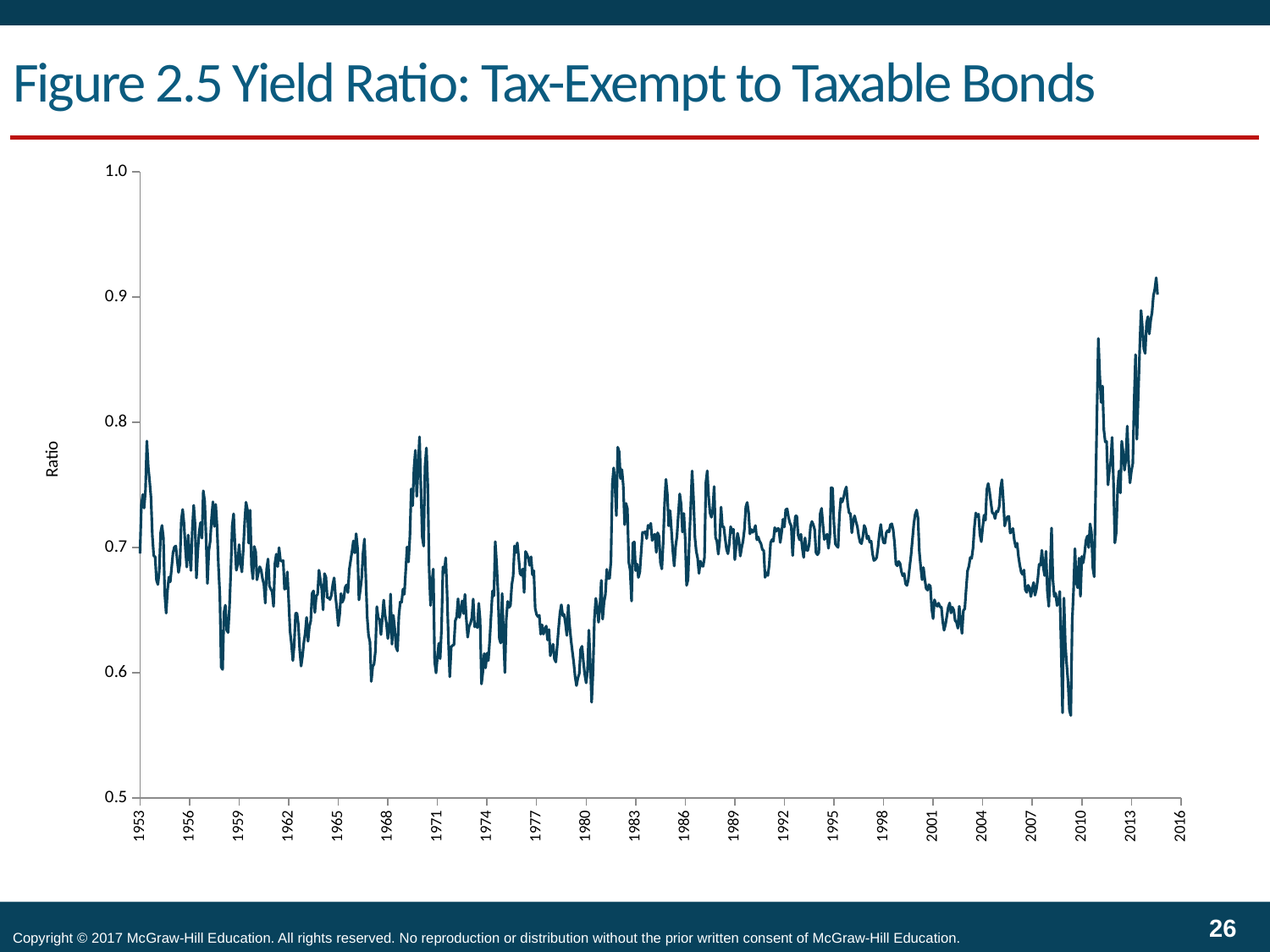
Is the lowest value reached by the ratio greater or less than 0.6? less What is the first year shown on the x axis? 1953 What is the label on the vertical axis? Ratio What is the lowest value marked on the y axis? 0.5 What is the highest value marked on the y axis? 1.0 What is the title of the chart? Figure 2.5 Yield Ratio: Tax-Exempt to Taxable Bonds What is the last year shown on the x axis? 2016 Is the peak value reached near the end of the series (around 2015) greater or less than 0.8? greater How many lines (data series) are plotted on the chart? 1 Does the ratio reach its highest value at the beginning or at the end of the period shown? end What kind of chart is shown on the slide? line chart Is the value of the ratio in 1995 greater or less than 0.8? less